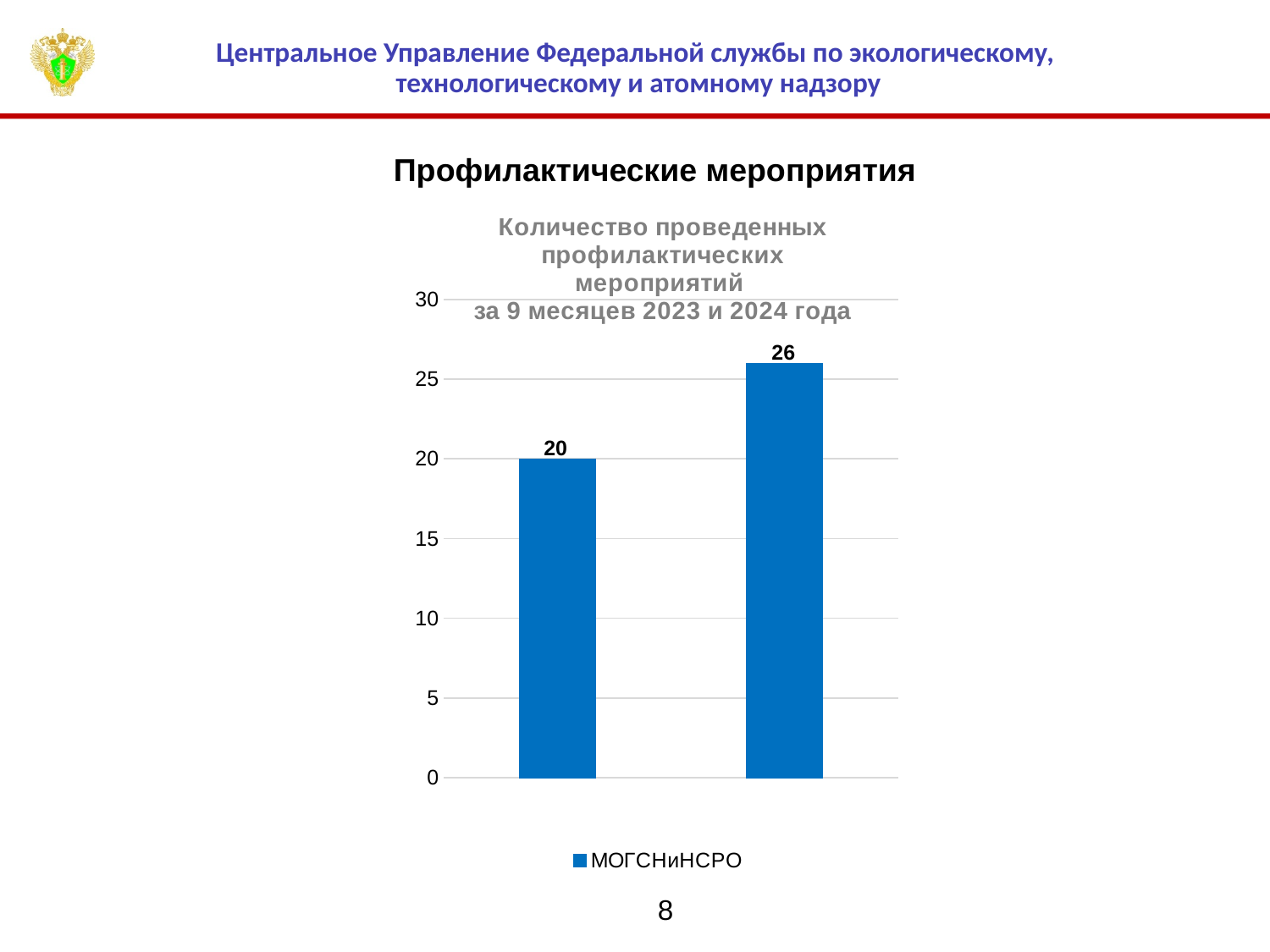
What is the difference between the right bar's value and the left bar's value? 6 What is the name of the series shown in the legend? МОГСНиНСРО What kind of chart is shown on the slide? bar chart Which bar has the lowest value, the left one or the right one? the left one What is the value of the left bar in the chart? 20 Which bar is taller, the left one or the right one? the right one Do the bar values rise or fall from left to right? rise How many series does the legend list? 1 What is the value of the right bar in the chart? 26 Is the value of the right bar greater or less than 25? greater How many bars are plotted in the chart? 2 Is the value of the left bar larger or smaller than the value of the right bar? smaller